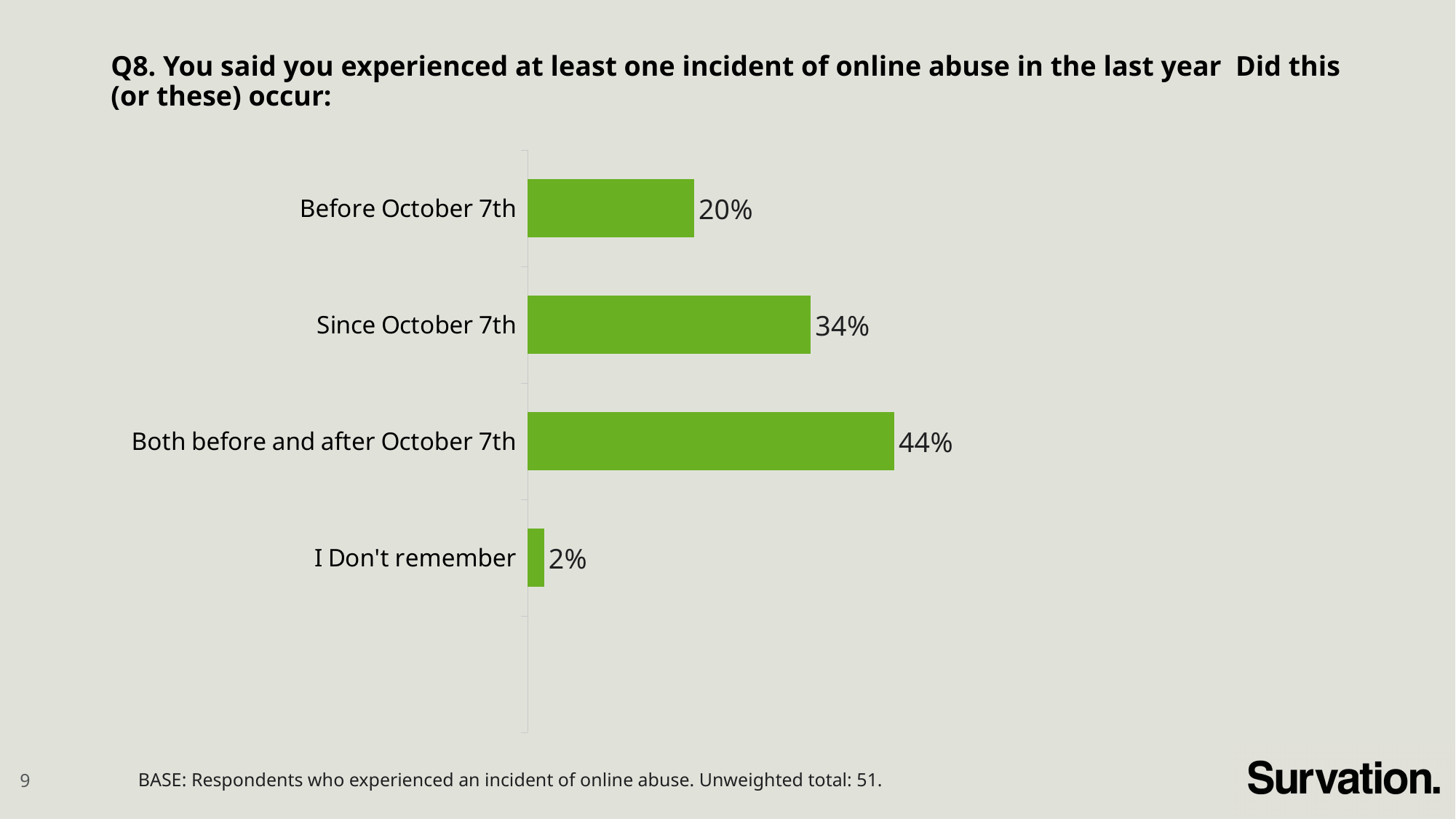
What is the unweighted total of respondents stated in the base note? 51 How many response categories are shown in the chart? 4 What percentage of respondents said the online abuse occurred before October 7th? 20% Which response option has the highest percentage? Both before and after October 7th What percentage of respondents said the online abuse occurred both before and after October 7th? 44% What percentage of respondents answered 'I Don't remember'? 2% What type of chart is shown on the slide? Bar chart What percentage of respondents said the online abuse occurred since October 7th? 34% Which is larger: the value for 'Since October 7th' or the value for 'Before October 7th'? Since October 7th Which response option has the lowest percentage? I Don't remember What is the difference in percentage points between 'Since October 7th' and 'Before October 7th'? 14 What is the difference in percentage points between 'Both before and after October 7th' and 'Since October 7th'? 10